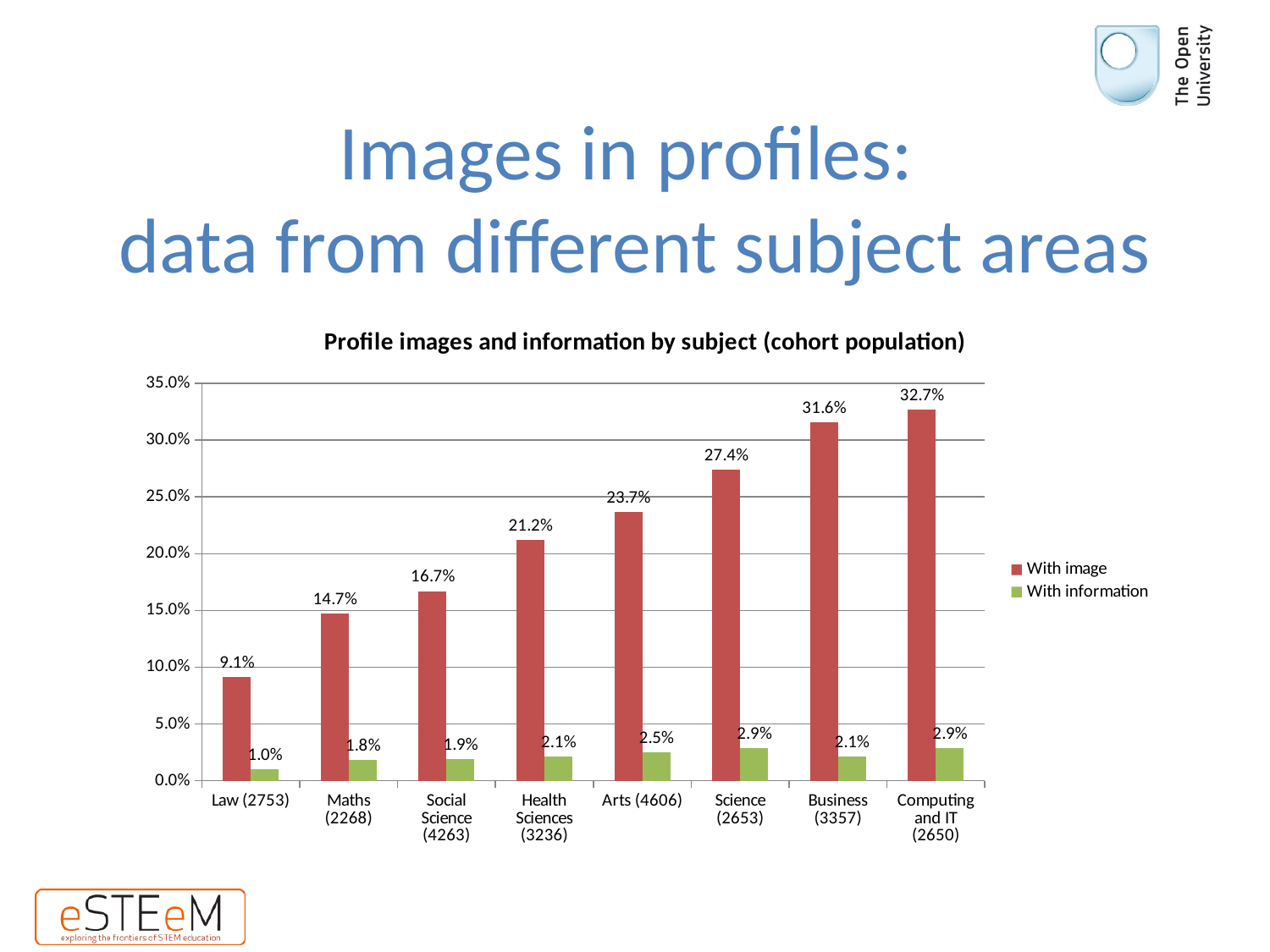
What is the 'With image' value for Health Sciences (3236)? 21.2% Which subject has the highest 'With image' value? Computing and IT (2650) How many series does the legend list? 2 What is the 'With information' value for Law (2753)? 1.0% Which is larger, the 'With information' value for Arts (4606) or for Maths (2268)? Arts (4606) What is the 'With image' value for Computing and IT (2650)? 32.7% What kind of chart is shown on the slide? Bar chart What is the difference between the 'With image' values for Business (3357) and Science (2653)? 4.2% Do the 'With image' values rise or fall from Law (2753) to Computing and IT (2650)? Rise How many subject categories are shown on the x axis? 8 Which subject has the lowest 'With image' value? Law (2753) Is the 'With image' value for Social Science (4263) greater or less than 15.0%? greater